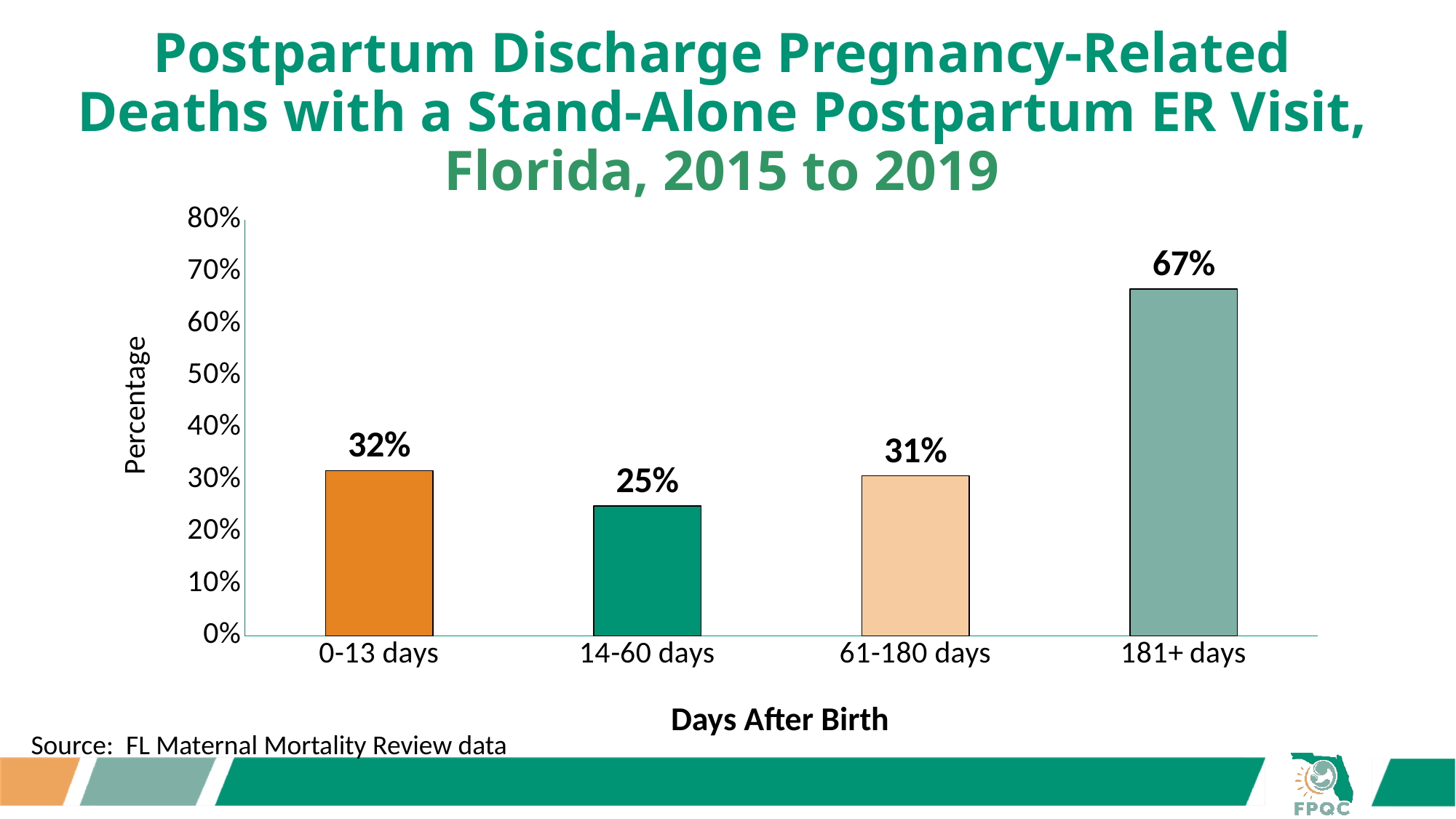
What kind of chart is shown on the slide? bar chart What is the value for 0-13 days? 32% Which is larger, the value for 0-13 days or the value for 14-60 days? 0-13 days What is the difference between the values for 181+ days and 0-13 days? 35% Which days-after-birth category has the lowest percentage? 14-60 days How many days-after-birth categories are shown on the x axis? 4 Is the value for 181+ days greater or less than 60%? greater What is the label of the x axis? Days After Birth What is the value for 14-60 days? 25% What is the value for 61-180 days? 31% What is the value for 181+ days? 67% Which days-after-birth category has the highest percentage? 181+ days